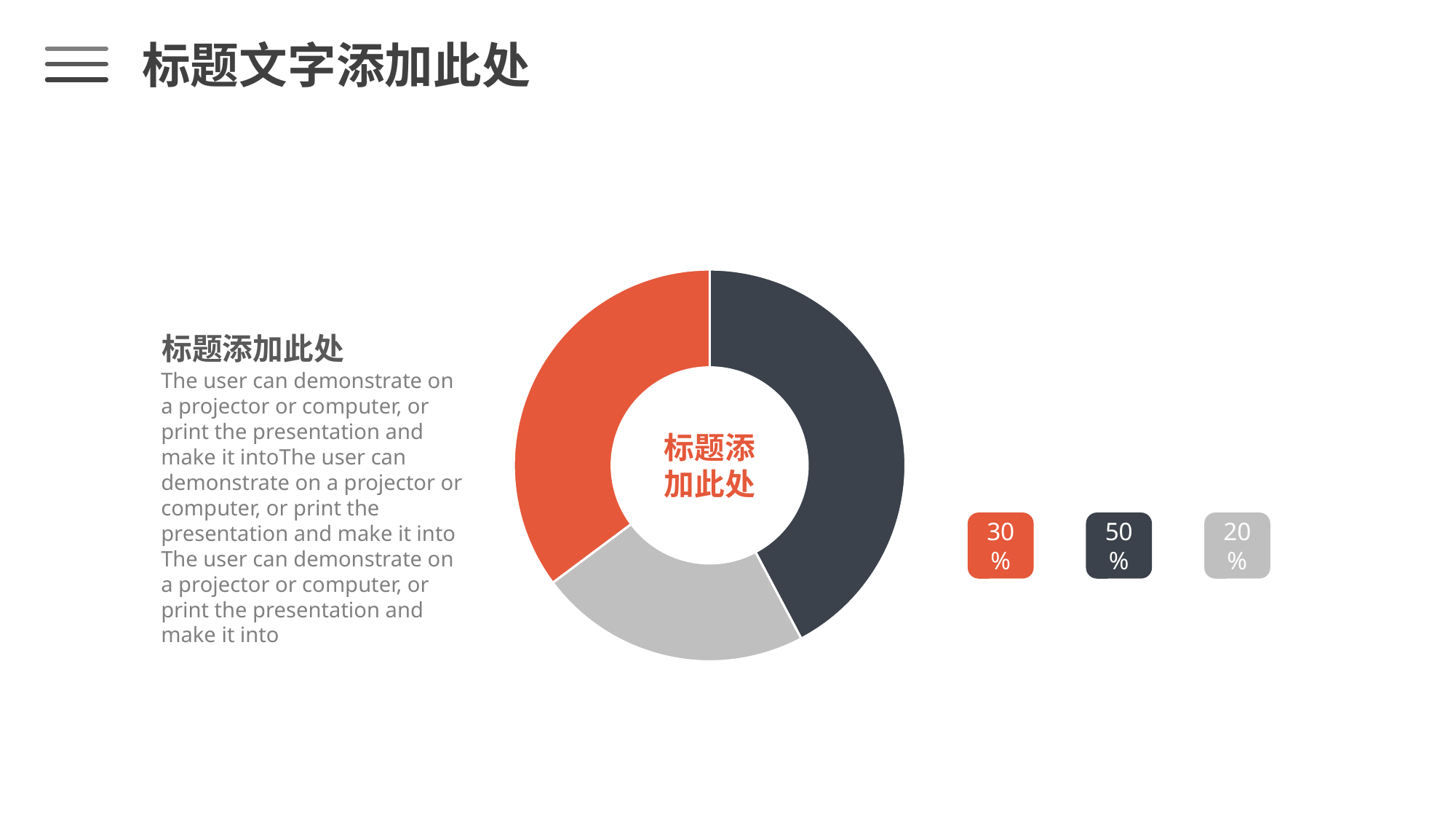
What text is shown in the centre of the donut chart? 标题添加此处 Which slice of the donut chart is the smallest? The light grey slice (20%) How many slices does the donut chart have? 3 Which is larger, the orange slice or the light grey slice? The orange slice What kind of chart is shown on the slide? Donut chart What is the combined share of the orange and light grey slices? 50% What colour is the slice labelled 50%? Dark grey What percentage is shown for the dark grey slice of the donut chart? 50% What percentage is shown for the light grey slice of the donut chart? 20% What percentage is shown for the orange slice of the donut chart? 30% What is the difference between the dark grey slice and the orange slice? 20% Which slice of the donut chart is the largest? The dark grey slice (50%)